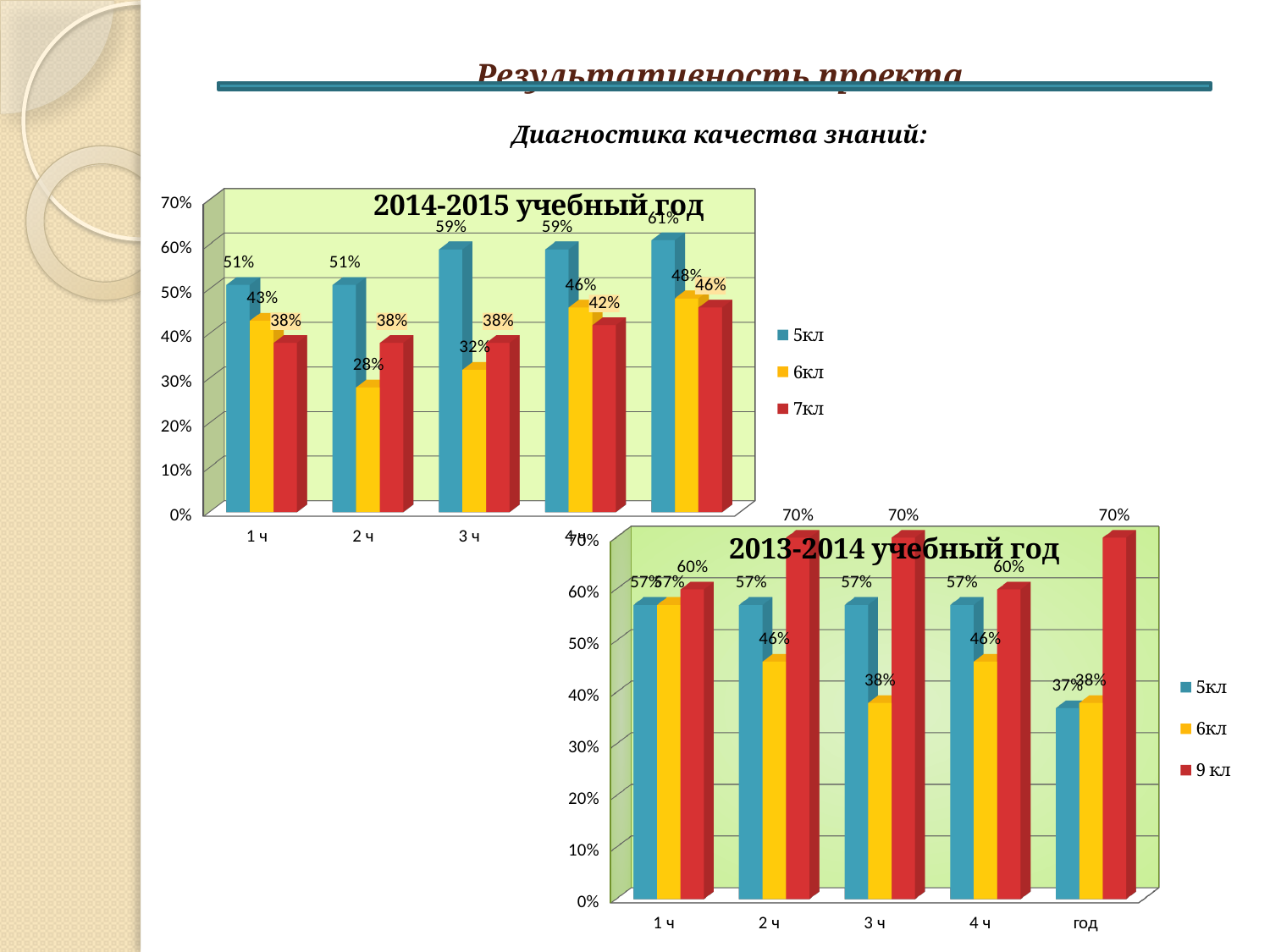
In the "2013-2014 учебный год" chart, what is the value for 5кл in год? 37% What type of chart is the "2013-2014 учебный год" chart? bar chart In the "2014-2015 учебный год" chart, which series has the lowest value in 3 ч? 6кл How many categories are shown on the x axis of the "2013-2014 учебный год" chart? 5 In the "2013-2014 учебный год" chart, which series has the highest value in 3 ч? 9 кл In the "2014-2015 учебный год" chart, what is the value for 6кл in 2 ч? 28% In the "2014-2015 учебный год" chart, what is the difference between 5кл and 6кл in 1 ч? 8% In the "2014-2015 учебный год" chart, what is the value for 7кл in 4 ч? 42% In the "2013-2014 учебный год" chart, what is the value for 9 кл in 2 ч? 70% In the "2013-2014 учебный год" chart, is the value for 6кл in 3 ч larger or smaller than the value for 6кл in 4 ч? smaller How many series does the legend of the "2014-2015 учебный год" chart list? 3 In the "2014-2015 учебный год" chart, what is the value for 5кл in 3 ч? 59%